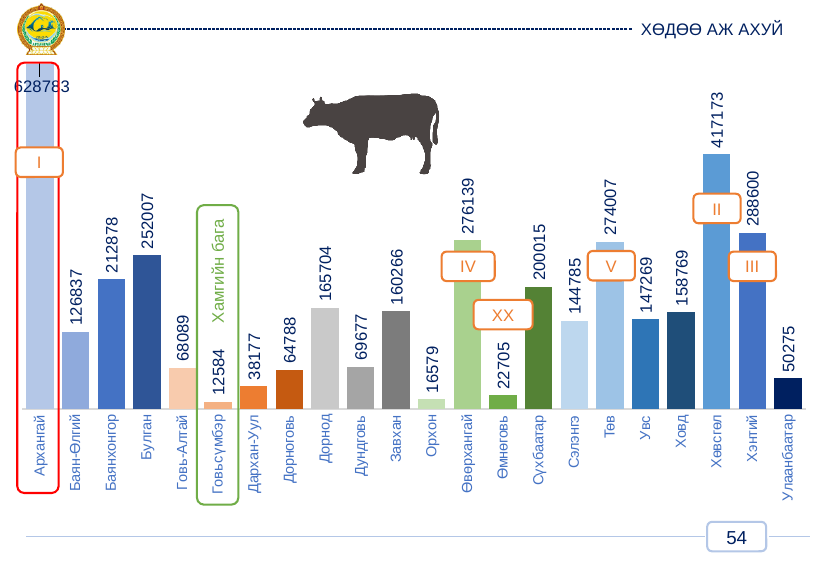
What is the value for Хөвсгөл? 417173 What is the difference between the values for Хөвсгөл and Хэнтий? 128573 Which category has the lowest value? Говьсүмбэр Which is larger, the value for Өвөрхангай or the value for Төв? Өвөрхангай What is the value for Говьсүмбэр? 12584 How many categories are shown in the chart? 22 What is the value for Сүхбаатар? 200015 Which category has the highest value? Архангай What is the difference between the values for Булган and Баянхонгор? 39129 Which category is marked with the green box labelled 'Хамгийн бага'? Говьсүмбэр What is the value for Архангай? 628783 What type of chart is shown on the slide? bar chart